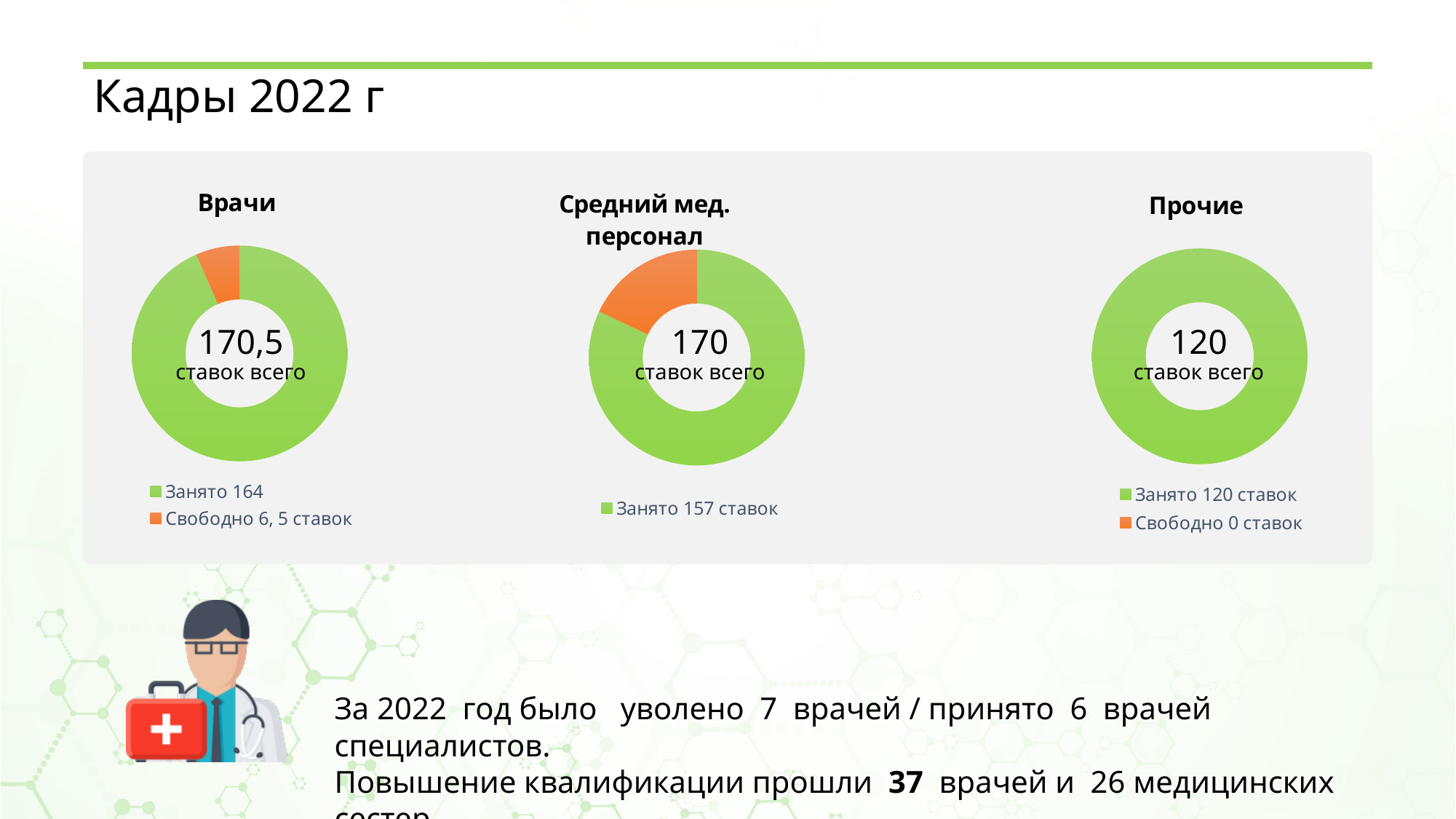
How many charts are shown on the slide? 3 How many entries does the legend of the "Прочие" chart list? 2 In the "Врачи" chart, what is the value for "Свободно"? 6, 5 ставок What kind of chart is used for "Врачи"? doughnut chart In the "Прочие" chart, how many ставок are "Свободно"? 0 In the "Врачи" chart, which is larger, "Занято" or "Свободно"? Занято In the "Средний мед. персонал" chart, what is the difference between the total ставок and the "Занято" value? 13 Which chart has the largest total number of ставок shown in its centre? Врачи In the "Средний мед. персонал" chart, how many ставок are "Занято"? 157 In the "Средний мед. персонал" chart, how many ставок всего are shown in the centre? 170 In the "Врачи" chart, how many ставок всего are shown in the centre? 170,5 In the "Врачи" chart, what is the value for "Занято"? 164